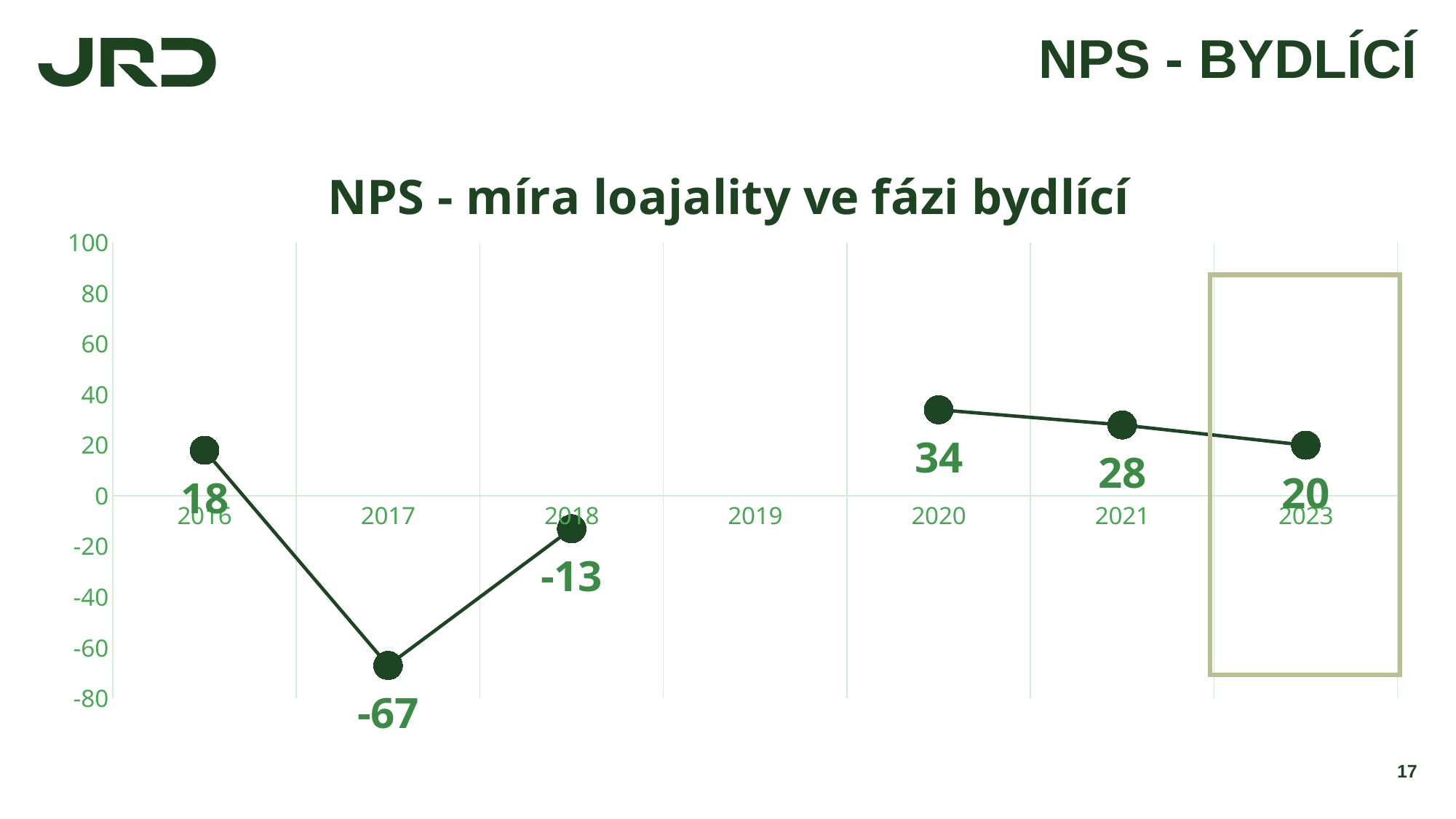
Do the NPS values rise or fall from 2020 to 2023? Fall What is the difference between the NPS values for 2016 and 2017? 85 What is the NPS value for 2020? 34 Which is larger, the NPS value for 2016 or for 2023? 2023 What type of chart is shown? Line chart Which year has the highest NPS value? 2020 Which year has the lowest NPS value? 2017 What is the title of the chart? NPS - míra loajality ve fázi bydlící What is the NPS value for 2023? 20 What is the difference between the NPS values for 2020 and 2021? 6 What is the NPS value for 2017? -67 How many data points are plotted on the line? 6